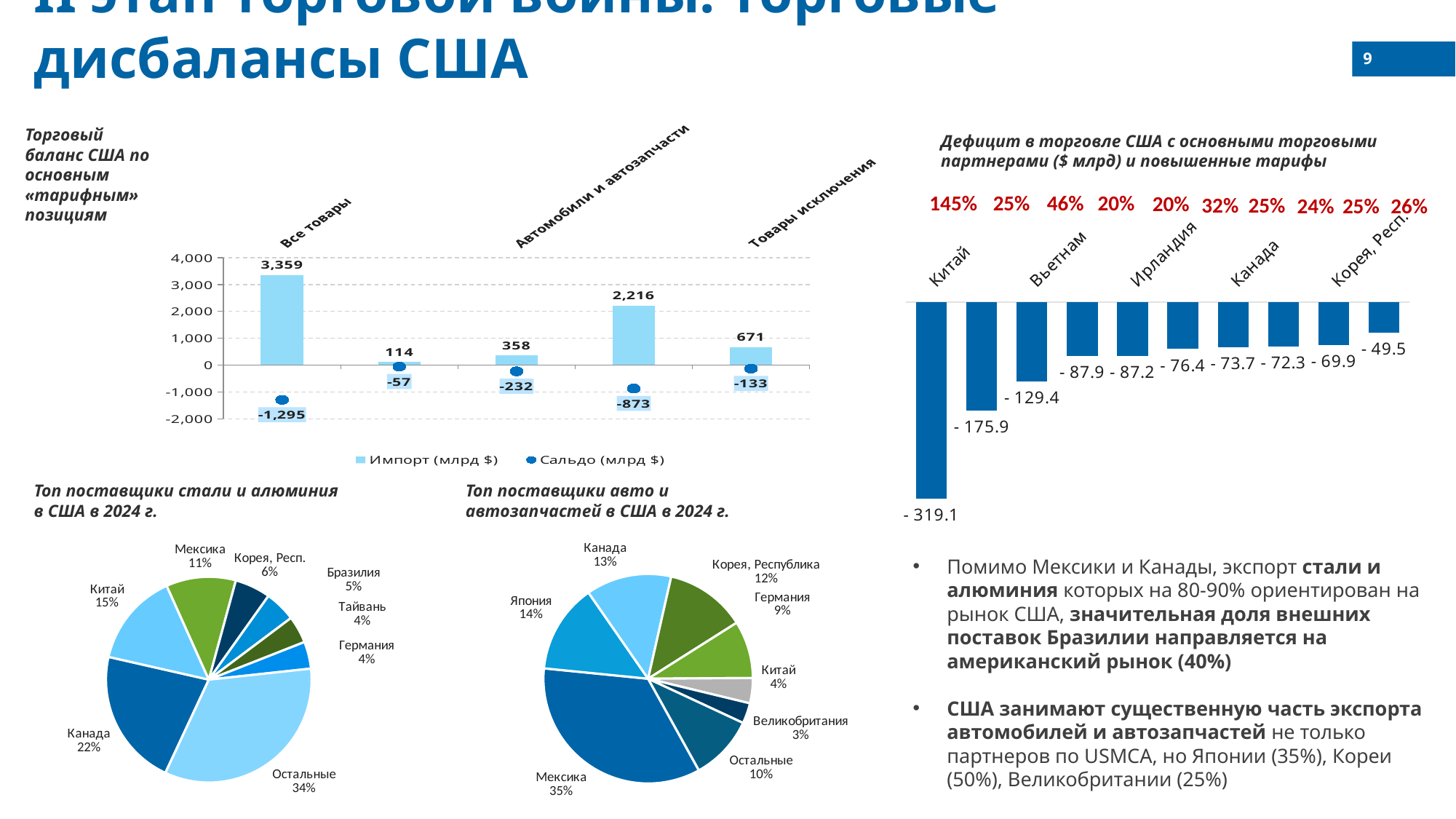
In the chart 'Дефицит в торговле США с основными торговыми партнерами', which partner has the largest deficit? Китай In the chart 'Торговый баланс США по основным «тарифным» позициям', what is the import value (млрд $) for 'Все товары'? 3,359 In the pie chart 'Топ поставщики авто и автозапчастей в США в 2024 г.', which is larger: the share of Япония or the share of Канада? Япония In the pie chart 'Топ поставщики стали и алюминия в США в 2024 г.', which named country (excluding 'Остальные') has the largest share? Канада In the chart 'Торговый баланс США по основным «тарифным» позициям', what is the import value for 'Товары исключения'? 671 In the pie chart 'Топ поставщики авто и автозапчастей в США в 2024 г.', what share does Мексика have? 35% In the chart 'Торговый баланс США по основным «тарифным» позициям', what is the difference between the import values for 'Все товары' and 'Автомобили и автозапчасти'? 3,001 In the chart 'Торговый баланс США по основным «тарифным» позициям', what is the 'Сальдо' value for 'Автомобили и автозапчасти'? -232 In the chart 'Торговый баланс США по основным «тарифным» позициям', how many series does the legend list? 2 In the pie chart 'Топ поставщики стали и алюминия в США в 2024 г.', what share does Канада have? 22% In the chart 'Дефицит в торговле США с основными торговыми партнерами', how many bars are plotted? 10 In the chart 'Дефицит в торговле США с основными торговыми партнерами', what is the deficit value for Китай? - 319.1